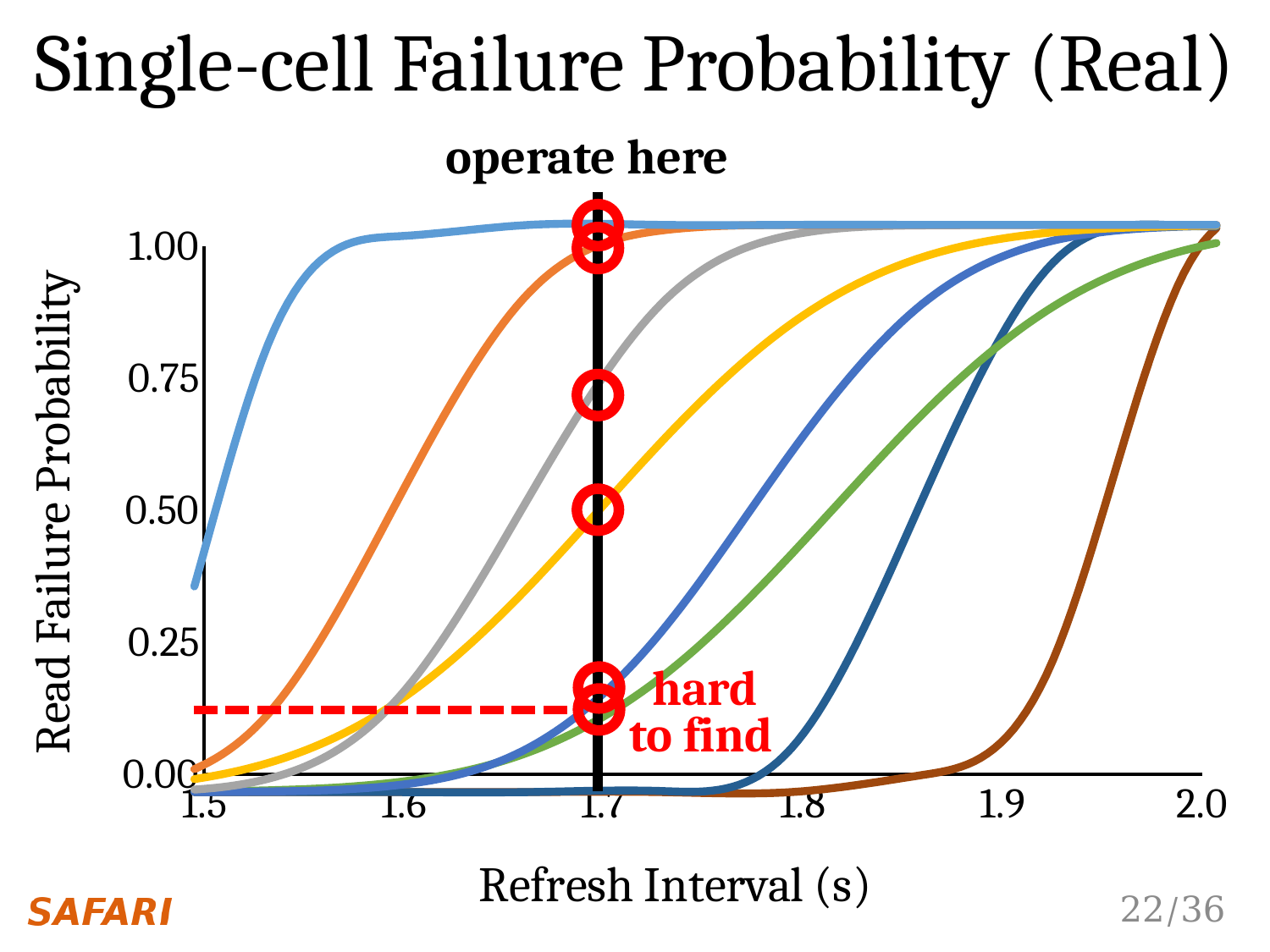
Is the value of the orange curve at a refresh interval of 1.7 greater or less than 0.75? greater What is the label of the y axis? Read Failure Probability What kind of chart is shown on the slide? line chart How many curves are plotted on the chart? 8 What is the range of the x axis, from its first tick to its last tick? 1.5 to 2.0 At what refresh interval is the vertical 'operate here' line drawn? 1.7 Is the value of the rightmost (brown) curve at a refresh interval of 1.8 greater or less than 0.25? less What is the highest tick value shown on the y axis? 1.00 How many red circles are marked on the vertical line at 1.7? 6 Do the curves rise or fall as the refresh interval increases along the x axis? rise What is the label of the x axis? Refresh Interval (s) Is the value of the leftmost (light blue) curve at a refresh interval of 1.6 greater or less than 0.75? greater